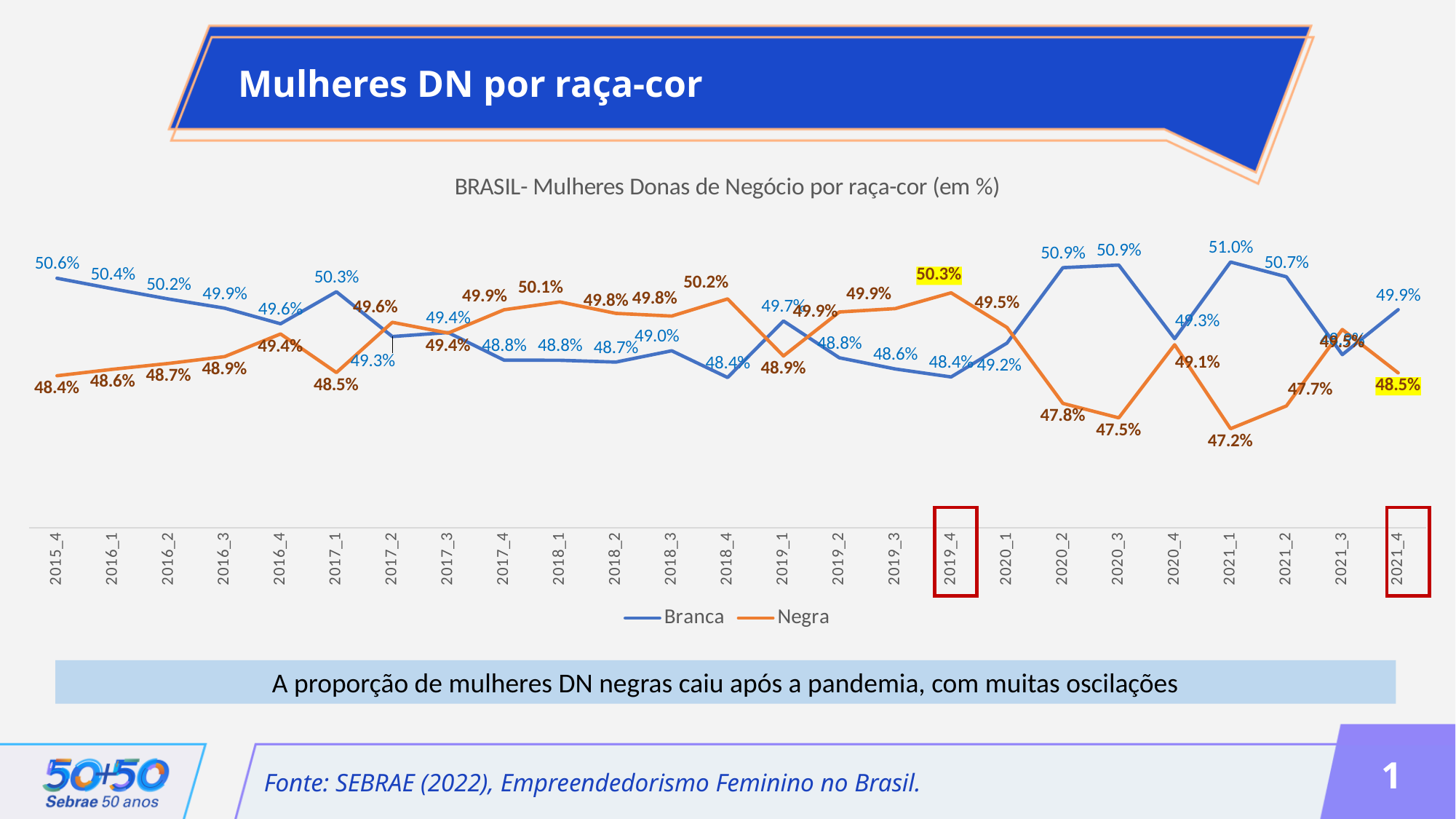
What is the difference between the Branca and Negra values in 2021_1? 3.8 percentage points What kind of chart is shown on the slide? Line chart In 2018_1, which series has the higher value, Branca or Negra? Negra What is the value for Branca in 2015_4? 50.6% What is the value for Branca in 2020_2? 50.9% How many series does the legend list? 2 In which period does the Branca series reach its highest value? 2021_1 What are the two entries in the chart legend? Branca and Negra What is the value for Negra in 2021_4? 48.5% In which period does the Negra series reach its lowest value? 2021_1 How many time periods are plotted along the x axis? 25 What is the value for Negra in 2019_4? 50.3%